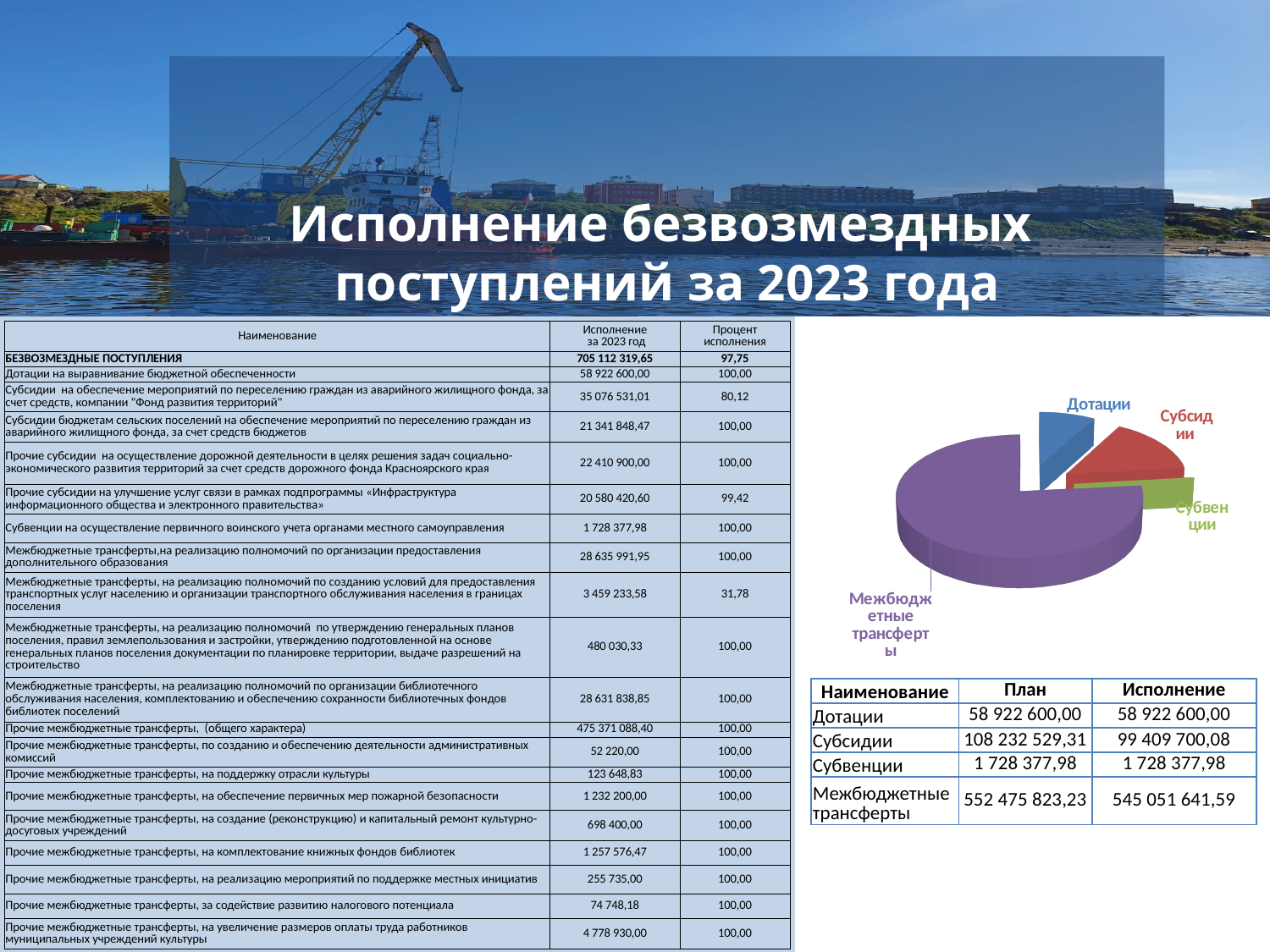
What kind of chart is shown on the right side of the slide? pie chart What colour is the Дотации slice in the pie chart? blue In the pie chart, which slice is larger: Субсидии or Субвенции? Субсидии How many slices does the pie chart have? 4 Which category has the smallest slice in the pie chart? Субвенции In the pie chart, which slice is larger: Межбюджетные трансферты or Субсидии? Межбюджетные трансферты Which category has the largest slice in the pie chart? Межбюджетные трансферты In the pie chart, which slice is larger: Дотации or Субвенции? Дотации What colour is the Межбюджетные трансферты slice in the pie chart? purple